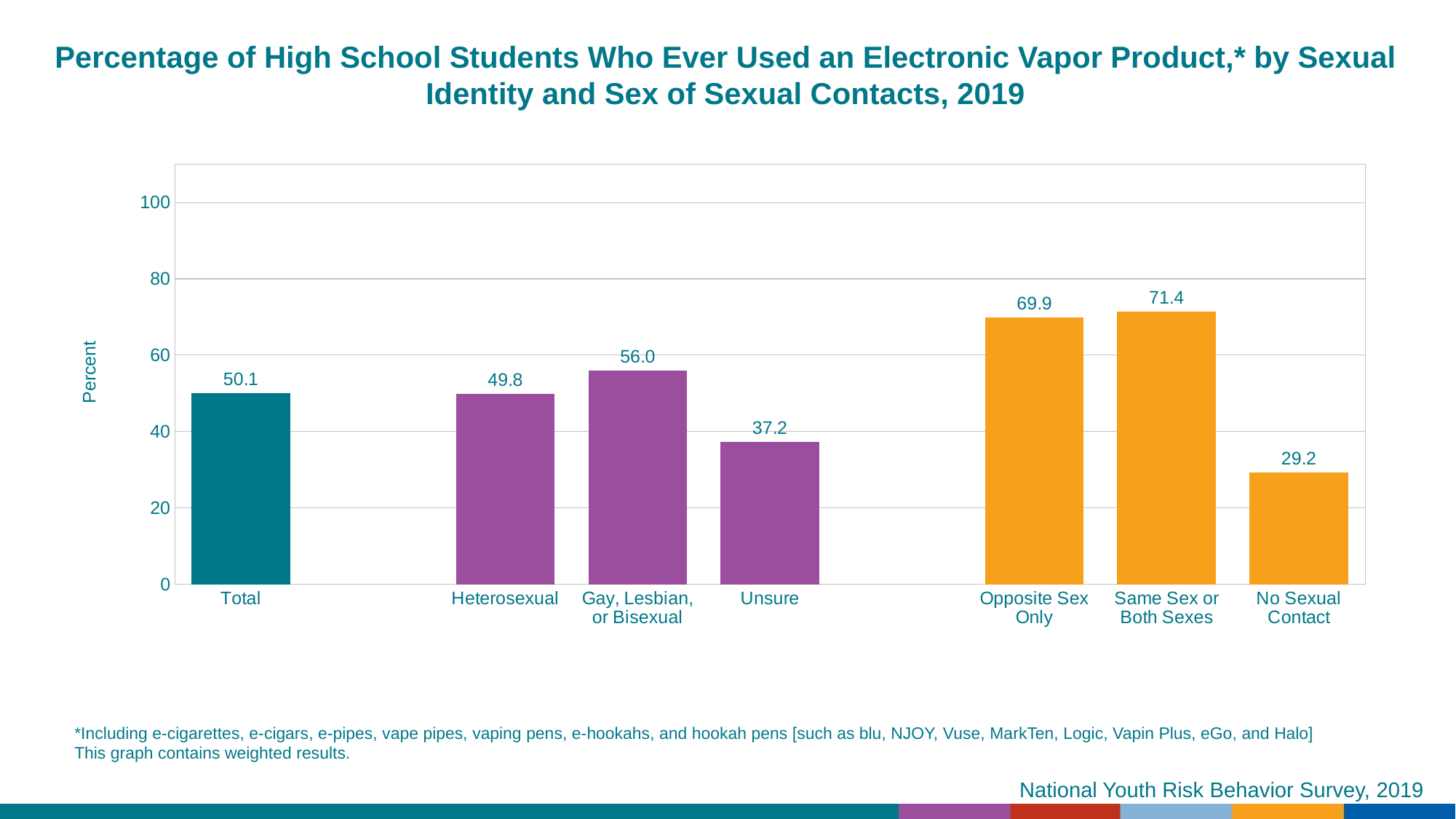
How many bars are shown in the chart? 7 Which category has the lowest value? No Sexual Contact Is the value for Opposite Sex Only greater or less than 60? greater What type of chart is shown on the slide? Bar chart Which category has the highest value? Same Sex or Both Sexes What is the value for students with No Sexual Contact? 29.2 What is the value for Unsure students? 37.2 What is the difference between the values for Opposite Sex Only and No Sexual Contact? 40.7 What is the value for Gay, Lesbian, or Bisexual students? 56.0 What is the value for Total? 50.1 Which is larger, the value for Heterosexual or the value for Unsure? Heterosexual What is the difference between the values for Gay, Lesbian, or Bisexual and Heterosexual? 6.2